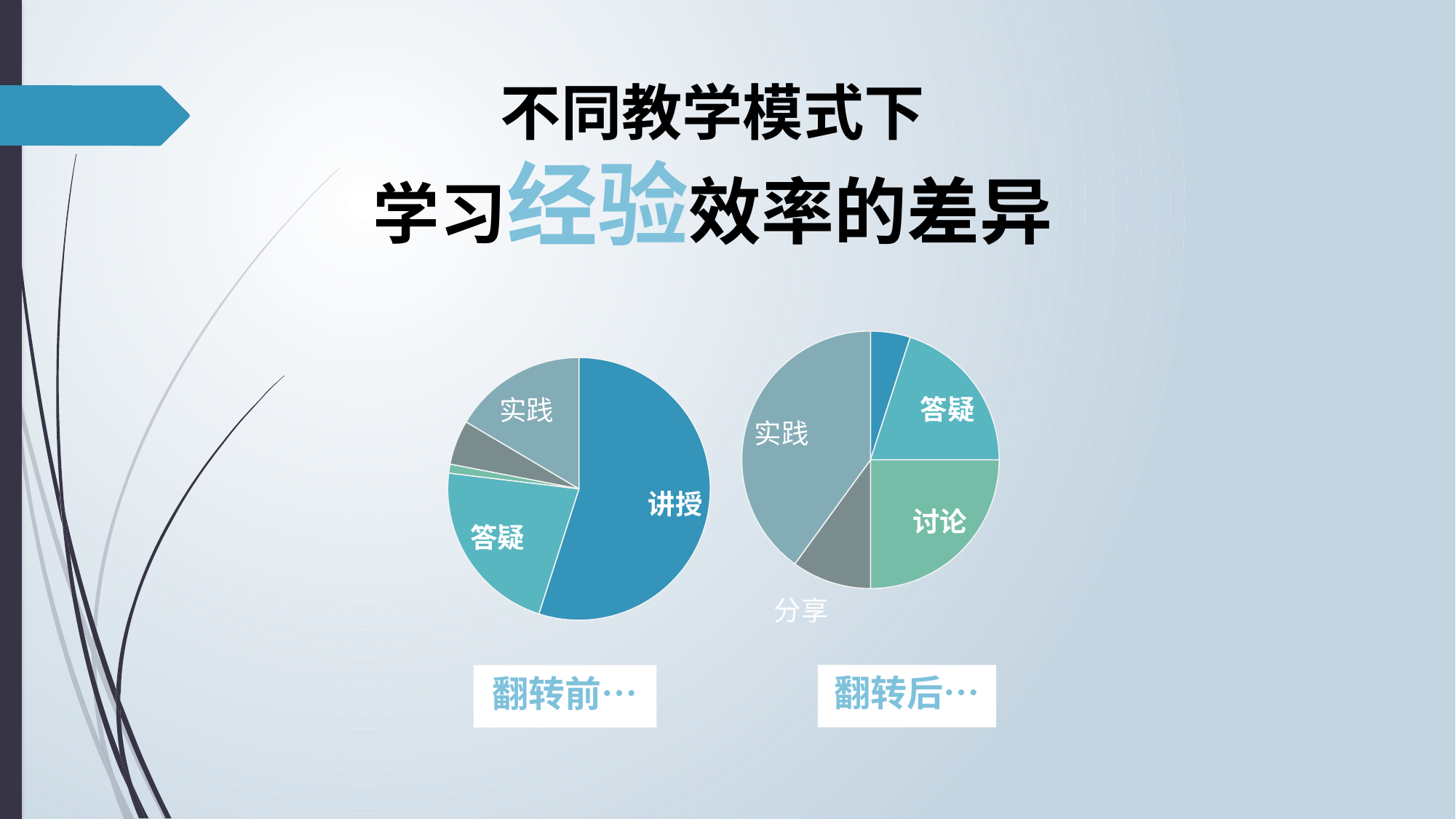
Which of the two pie charts contains a slice labelled 讲授? 翻转前… What kind of chart is the chart labelled 翻转前…? pie chart What kind of chart is the chart labelled 翻转后…? pie chart How many slices does the 翻转后… pie chart have? 5 Which of the two pie charts contains a slice labelled 讨论? 翻转后… In the 翻转后… pie chart, which slice is larger, 讨论 or 分享? 讨论 In the 翻转前… pie chart, which slice is the largest? 讲授 In the 翻转后… pie chart, which slice is the largest? 实践 In the 翻转后… pie chart, which slice is larger, 实践 or 讨论? 实践 In the 翻转前… pie chart, which slice is larger, 讲授 or 答疑? 讲授 How many slices does the 翻转前… pie chart have? 5